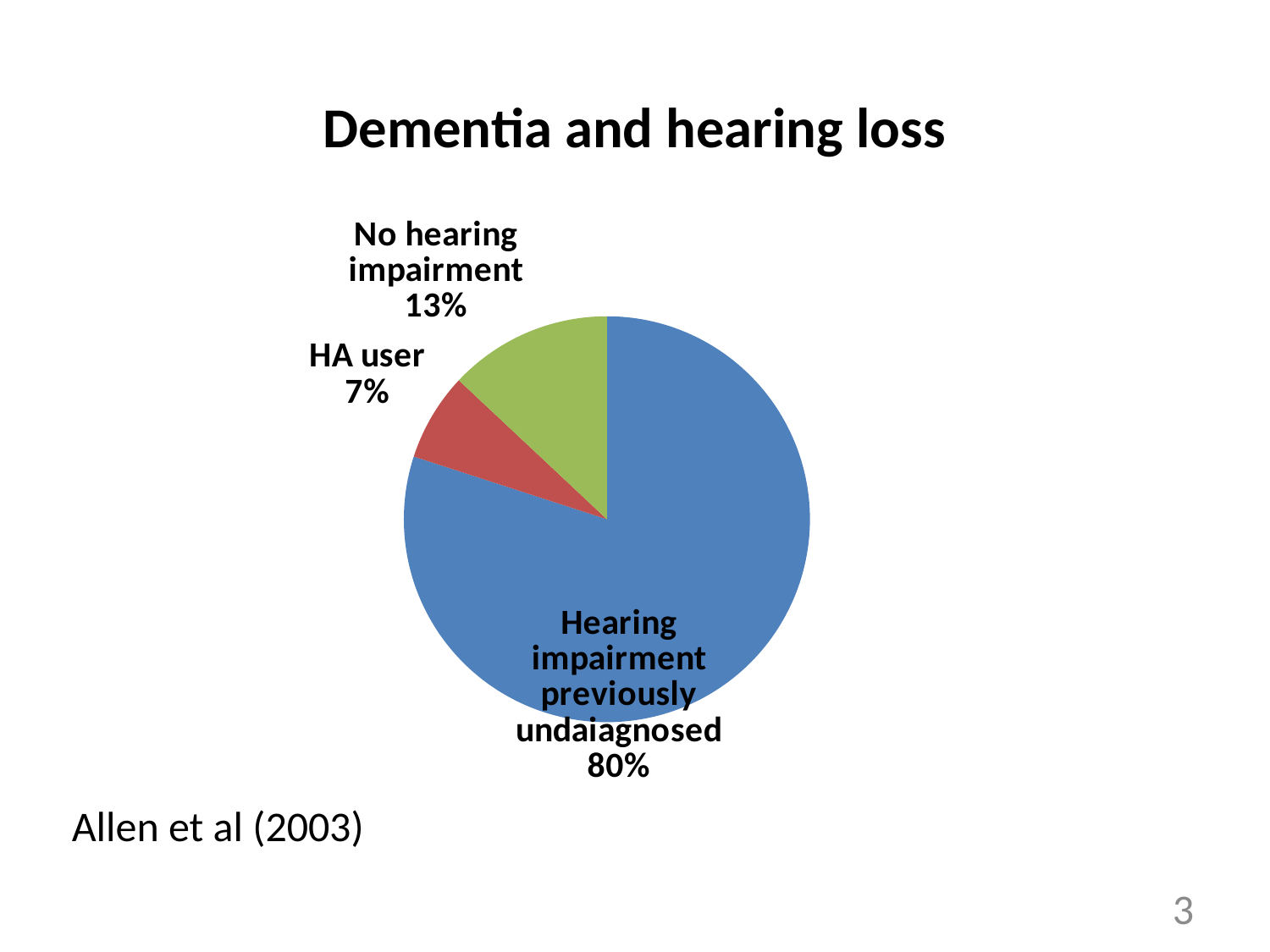
Which is larger, the 'No hearing impairment' slice or the 'HA user' slice? No hearing impairment What is the title of the chart? Dementia and hearing loss What colour is the 'HA user' slice? red What share of the pie is labelled 'HA user'? 7% What kind of chart is shown on the slide? pie chart What share of the pie is labelled 'Hearing impairment previously undaiagnosed'? 80% Which slice of the pie is the smallest? HA user What is the difference in percentage points between the 'No hearing impairment' slice and the 'HA user' slice? 6% What is the difference in percentage points between the 'Hearing impairment previously undaiagnosed' slice and the 'No hearing impairment' slice? 67% What share of the pie is labelled 'No hearing impairment'? 13% How many slices does the pie chart have? 3 Which slice of the pie is the largest? Hearing impairment previously undaiagnosed